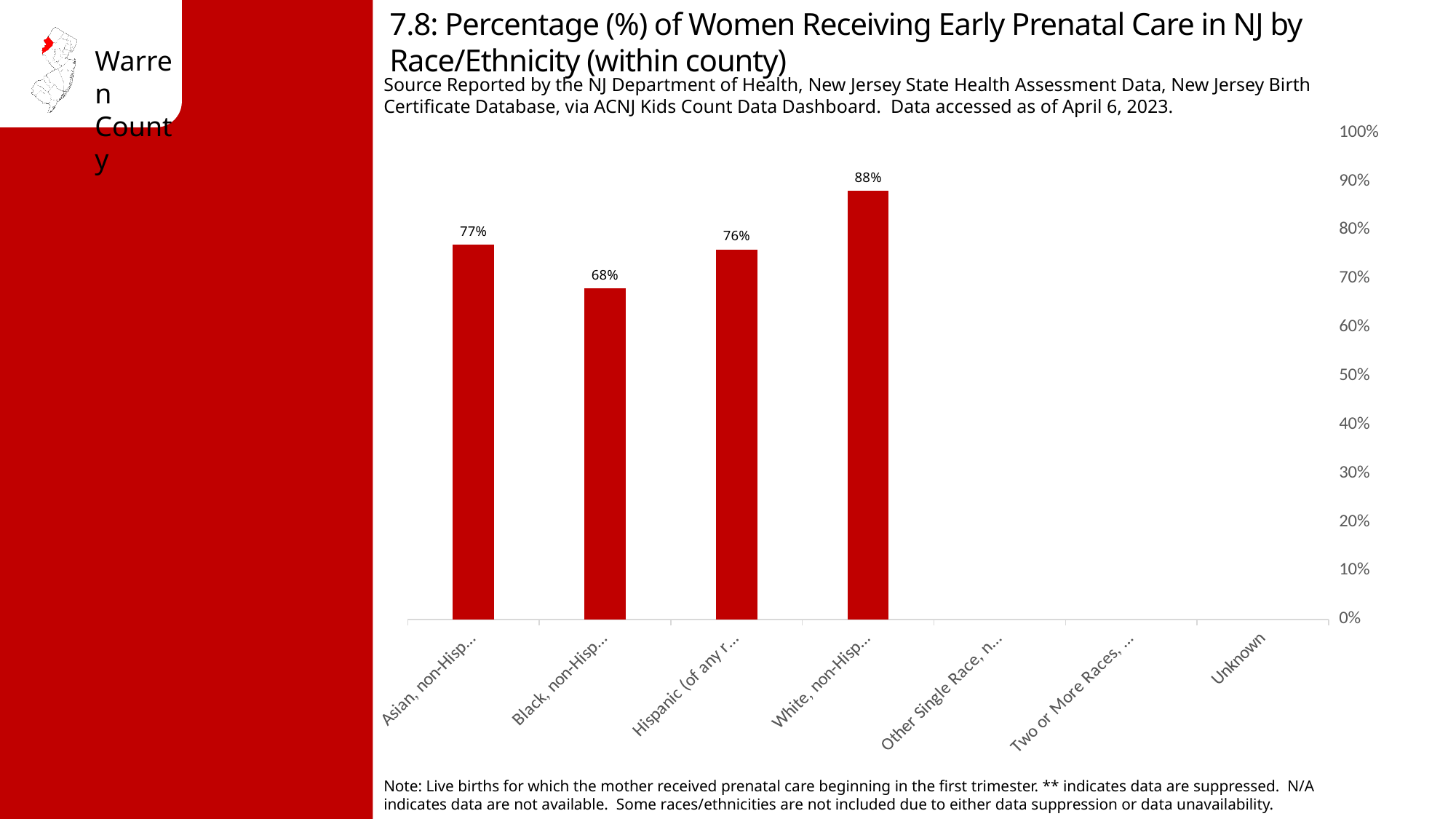
What type of chart is shown on the slide? Bar chart What is the value shown for Hispanic (of any race) women? 76% What is the value shown for Asian, non-Hispanic women? 77% Among the groups with a plotted bar, which has the lowest percentage? Black, non-Hispanic What percentage of Black, non-Hispanic women received early prenatal care? 68% Which race/ethnicity group has the highest percentage of women receiving early prenatal care? White, non-Hispanic What is the maximum value shown on the vertical axis? 100% What is the difference in percentage points between the White, non-Hispanic and Black, non-Hispanic bars? 20 How many race/ethnicity categories are labeled on the x axis? 7 What percentage of White, non-Hispanic women received early prenatal care? 88% Is the value for Black, non-Hispanic greater or less than 70%? less Which is larger, the value for Asian, non-Hispanic or the value for Black, non-Hispanic? Asian, non-Hispanic